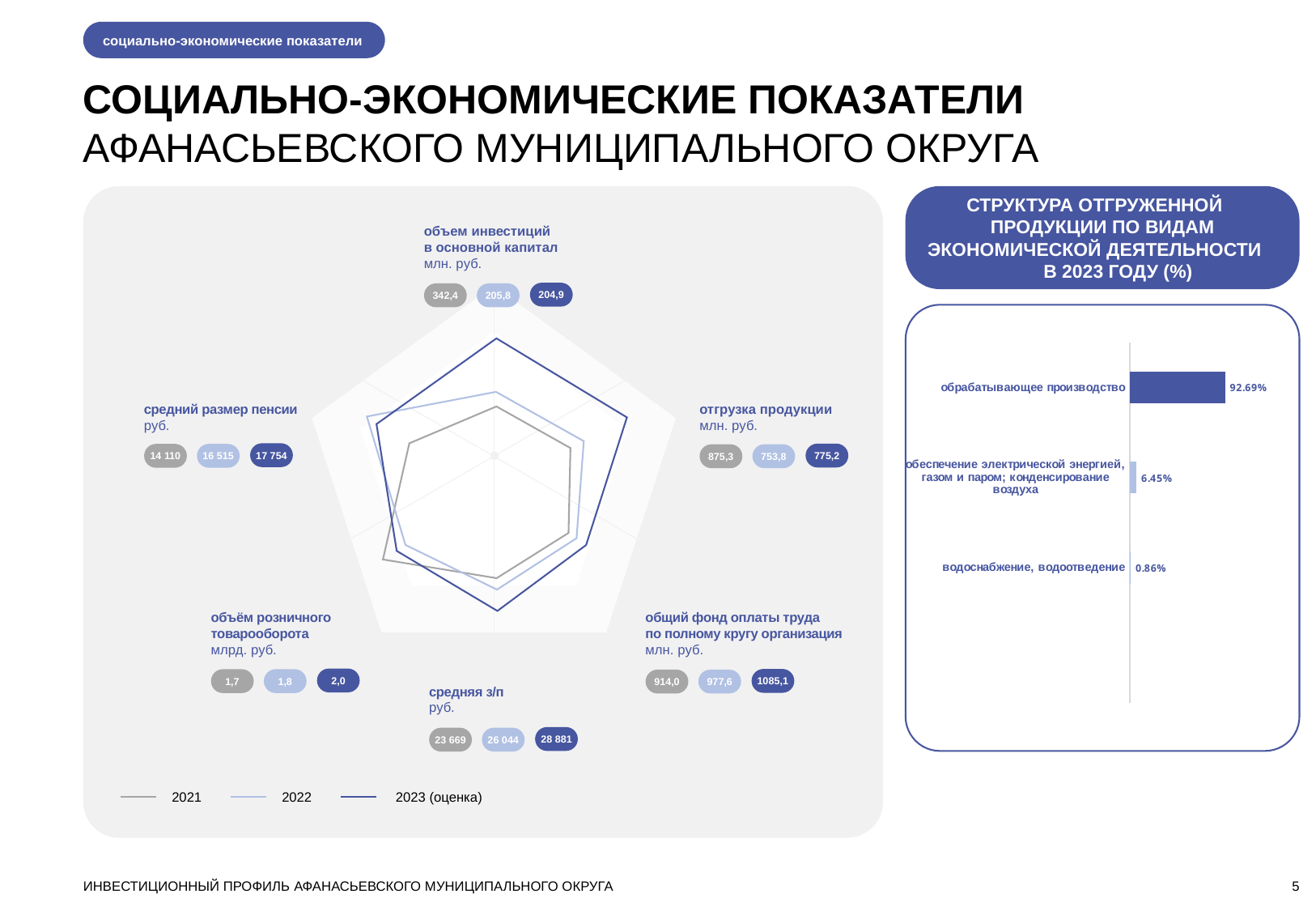
On the bar chart on the right, what is the value for обрабатывающее производство? 92.69% On the radar chart on the left, what is the 2021 value for объем инвестиций в основной капитал? 342,4 On the radar chart on the left, which is larger for отгрузка продукции: the 2021 value or the 2023 (оценка) value? 2021 On the radar chart on the left, do the values for общий фонд оплаты труда rise or fall from 2021 to 2023 (оценка)? rise What kind of chart is the chart on the right? bar chart On the radar chart on the left, what is the difference between the 2023 (оценка) and 2021 values for средний размер пенсии? 3 644 On the radar chart on the left, how many series does the legend list? 3 On the radar chart on the left, what is the 2023 (оценка) value for средняя з/п? 28 881 On the bar chart on the right, which category has the lowest value? водоснабжение, водоотведение On the bar chart on the right, how many categories are shown? 3 On the radar chart on the left, what is the 2022 value for объём розничного товарооборота? 1,8 On the bar chart on the right, what is the difference between the values for обрабатывающее производство and обеспечение электрической энергией, газом и паром; конденсирование воздуха? 86.24%